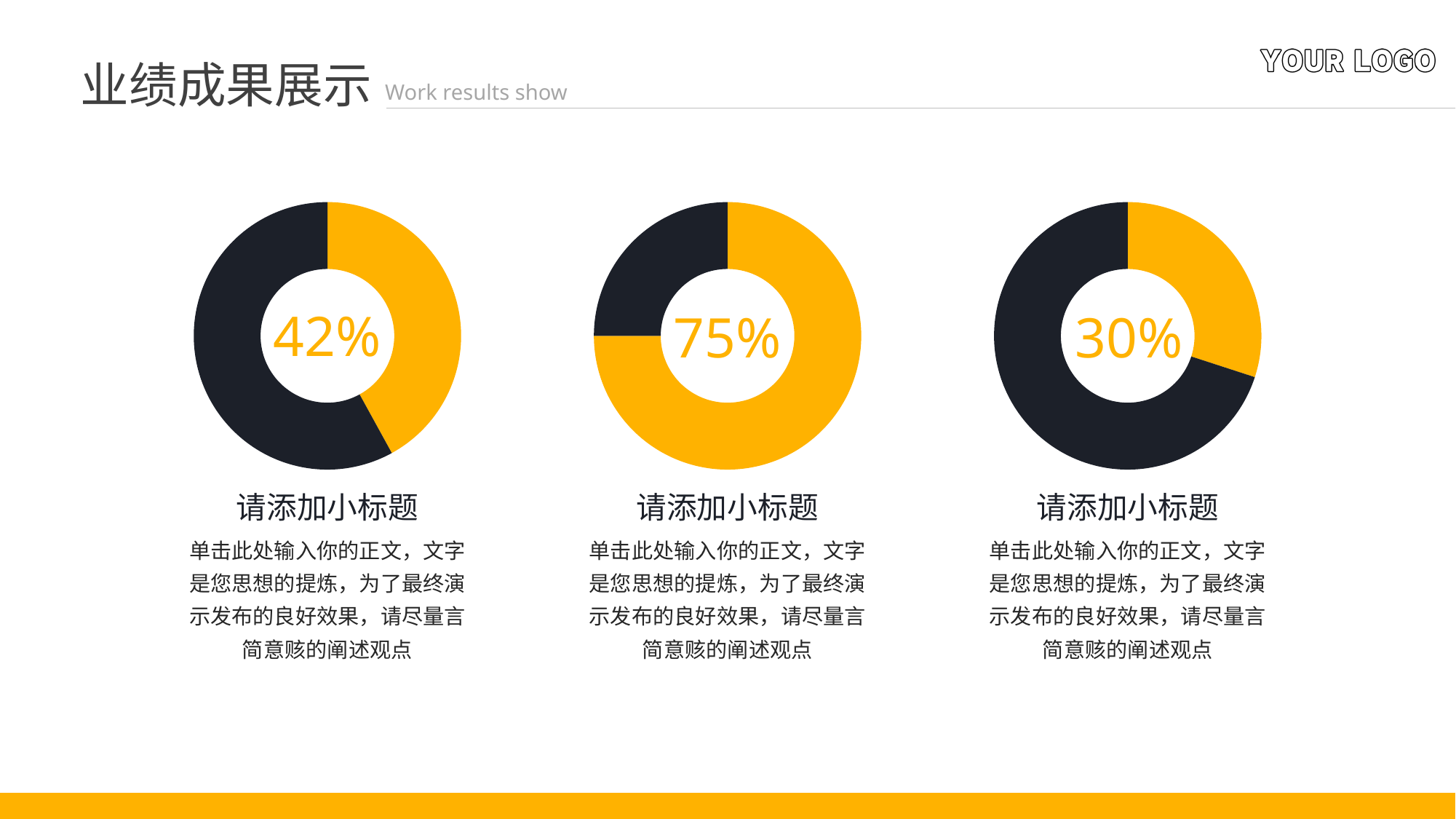
Which is larger, the percentage in the left donut chart or the percentage in the right donut chart? The left chart (42%) How many donut charts are shown on the slide? 3 What percentage is shown in the centre of the left donut chart? 42% Which of the three donut charts shows the highest percentage? The middle chart (75%) What percentage is shown in the centre of the middle donut chart? 75% What is the difference between the percentage in the left donut chart and the percentage in the right donut chart? 12% What colour is the segment that represents the highlighted percentage in each donut chart? Yellow Which of the three donut charts shows the lowest percentage? The right chart (30%) What percentage is shown in the centre of the right donut chart? 30% What kind of chart is used to display the percentages on this slide? Donut chart In the middle donut chart, what share of the ring is taken by the dark segment? 25% What is the difference between the percentage in the middle donut chart and the percentage in the left donut chart? 33%